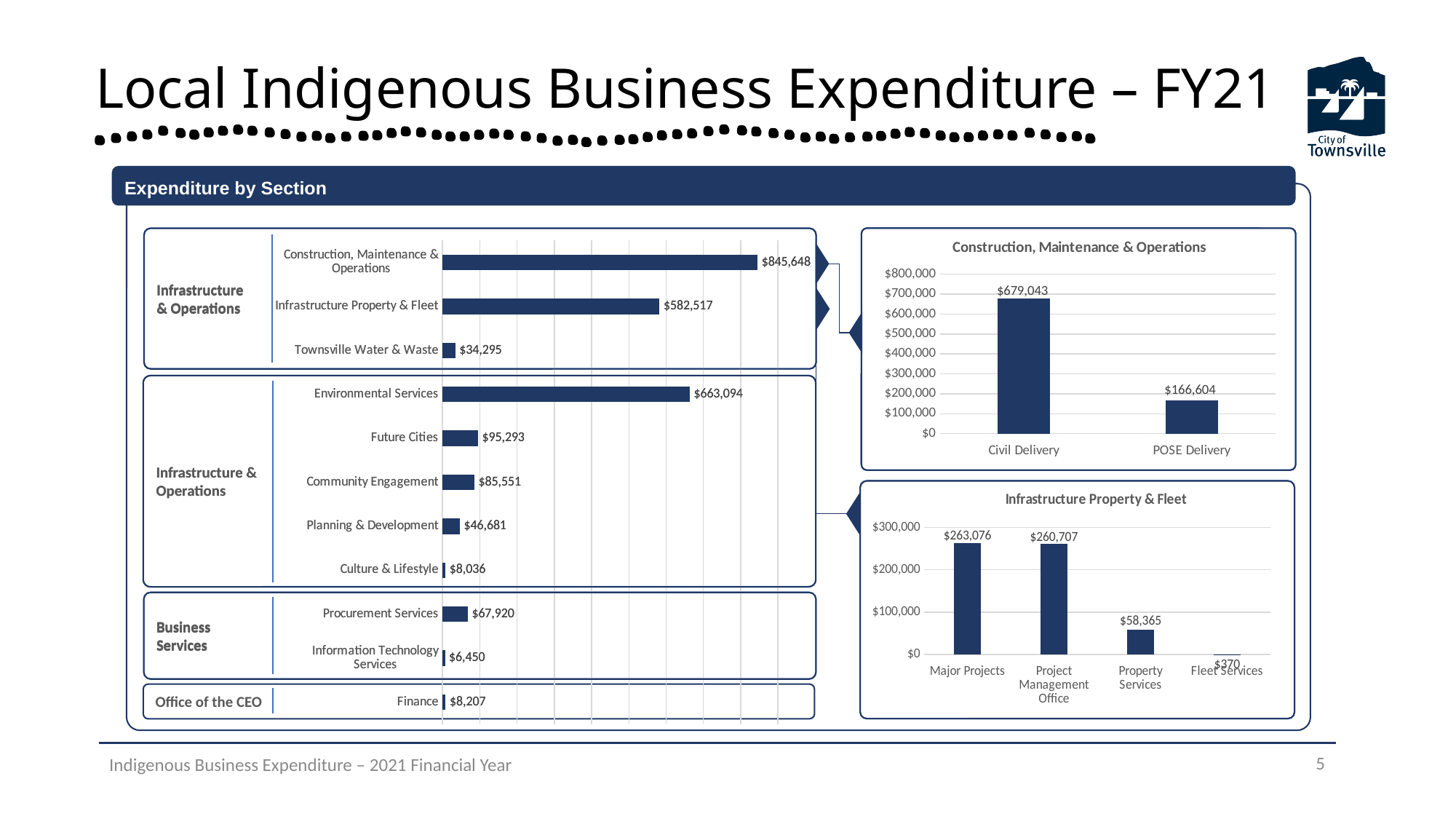
In the Expenditure by Section chart on the left, what is the value for Environmental Services? $663,094 In the Expenditure by Section chart on the left, which category has the lowest value? Information Technology Services In the Expenditure by Section chart on the left, what is the difference between Construction, Maintenance & Operations and Infrastructure Property & Fleet? $263,131 In the Construction, Maintenance & Operations chart at the top right, what is the value for POSE Delivery? $166,604 What kind of chart is the Infrastructure Property & Fleet chart at the bottom right? Bar chart In the Infrastructure Property & Fleet chart at the bottom right, which is larger, Major Projects or Project Management Office? Major Projects In the Expenditure by Section chart on the left, what is the value for Townsville Water & Waste? $34,295 In the Construction, Maintenance & Operations chart at the top right, what is the difference between Civil Delivery and POSE Delivery? $512,439 In the Infrastructure Property & Fleet chart at the bottom right, which category has the lowest value? Fleet Services In the Infrastructure Property & Fleet chart at the bottom right, what is the value for Property Services? $58,365 In the Expenditure by Section chart on the left, which category has the highest value? Construction, Maintenance & Operations In the Expenditure by Section chart on the left, how many categories are plotted? 11